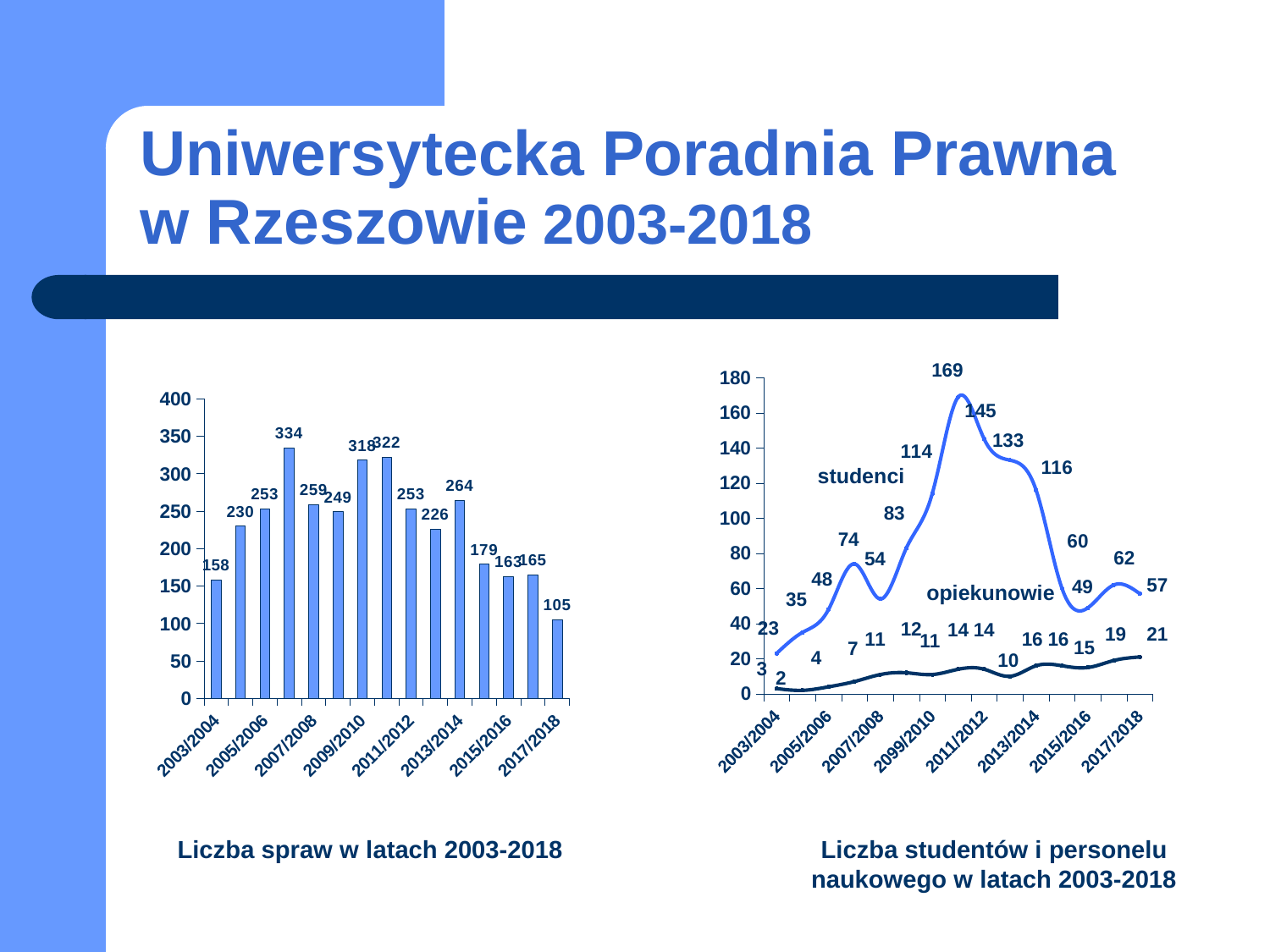
How many bars are plotted in the left chart 'Liczba spraw w latach 2003-2018'? 15 In the left chart 'Liczba spraw w latach 2003-2018', what is the difference between the values for 2003/2004 and 2017/2018? 53 What kind of chart is the left chart, 'Liczba spraw w latach 2003-2018'? bar chart In the left chart 'Liczba spraw w latach 2003-2018', what is the value for 2017/2018? 105 In the right chart 'Liczba studentów i personelu naukowego w latach 2003-2018', what is the value of 'opiekunowie' for 2017/2018? 21 In the right chart 'Liczba studentów i personelu naukowego w latach 2003-2018', which series has the larger value for 2003/2004, 'studenci' or 'opiekunowie'? studenci In the right chart 'Liczba studentów i personelu naukowego w latach 2003-2018', what is the highest value of the 'studenci' series? 169 In the left chart 'Liczba spraw w latach 2003-2018', which year has the lowest value? 2017/2018 How many series are plotted in the right chart 'Liczba studentów i personelu naukowego w latach 2003-2018'? 2 In the left chart 'Liczba spraw w latach 2003-2018', what is the highest value shown? 334 In the left chart 'Liczba spraw w latach 2003-2018', what is the value for 2003/2004? 158 What kind of chart is the right chart, 'Liczba studentów i personelu naukowego w latach 2003-2018'? line chart